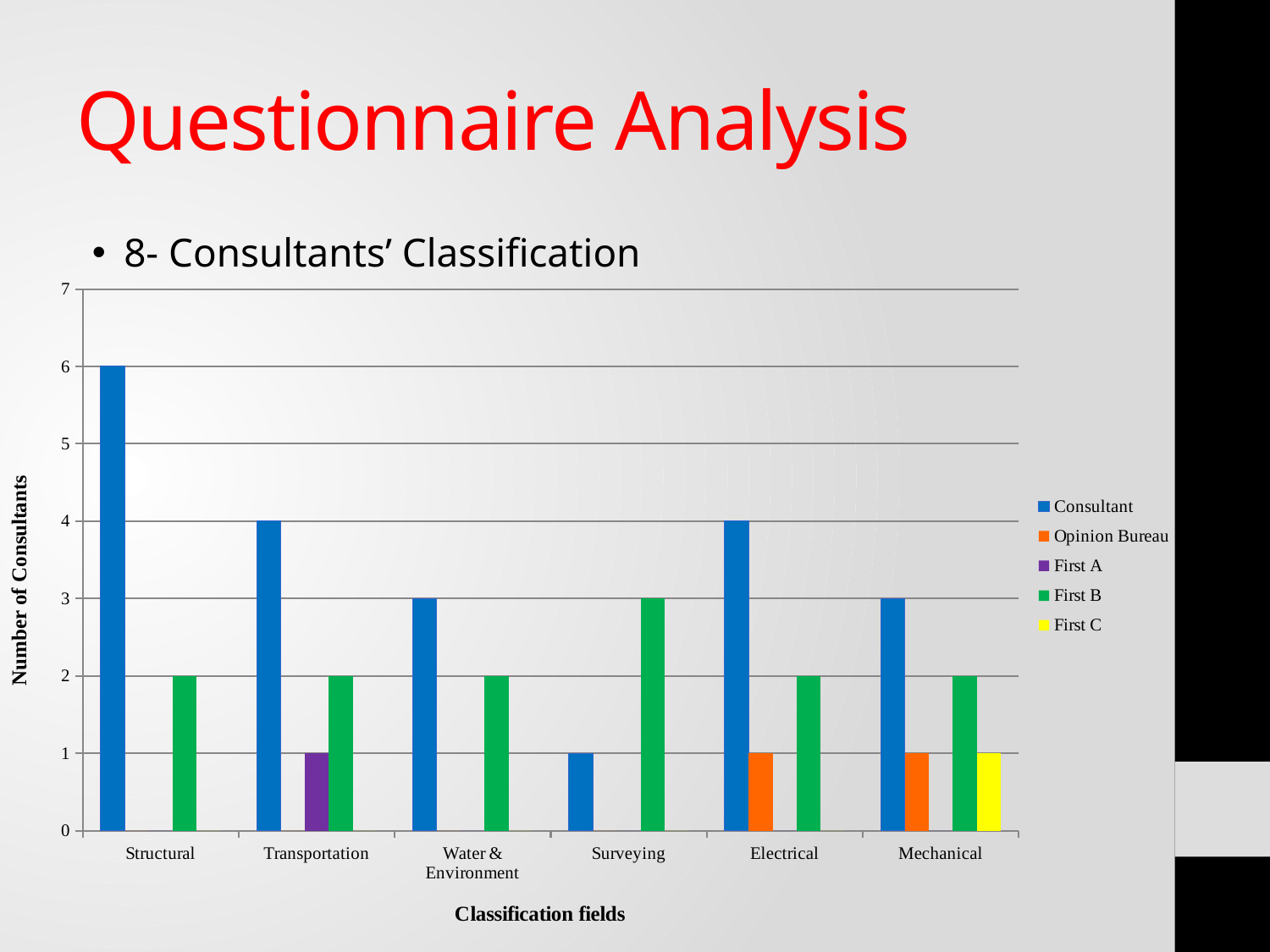
How many classification fields are shown on the x axis? 6 Which classification field has the lowest value for the Consultant series? Surveying In the Surveying field, which is larger: the Consultant value or the First B value? First B What is the value of the First A series for Transportation? 1 What type of chart is shown on the slide? bar chart Which classification field has the highest value for the Consultant series? Structural Which is the only classification field with a First C bar? Mechanical What is the difference between the Consultant value for Structural and the Consultant value for Electrical? 2 What is the label of the y axis? Number of Consultants How many series does the legend list? 5 What is the value of the First B series for Surveying? 3 What is the number of consultants for the Consultant series in the Structural field? 6